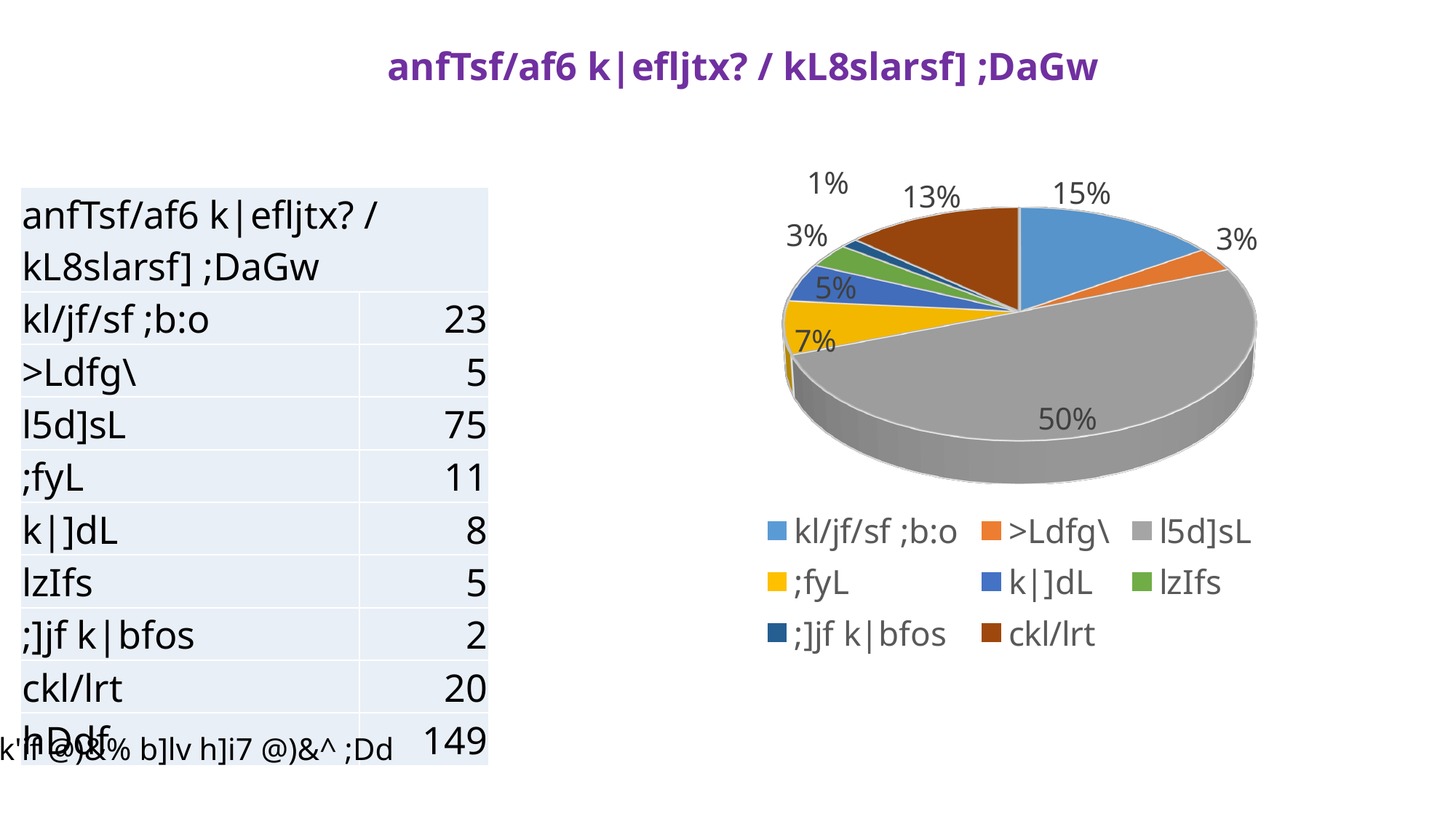
Which category has the smallest slice of the pie? ;]jf k|bfos What percentage is shown for the ckl/lrt slice? 13% What percentage is shown for the ;fyL slice? 7% What share of the pie does the l5d]sL slice represent? 50% How many entries does the legend list? 8 What is the difference in percentage points between the l5d]sL slice and the kl/jf/sf ;b:o slice? 35 How many slices does the pie chart have? 8 Which category has the largest slice of the pie? l5d]sL What percentage is shown for the k|]dL slice? 5% Which slice is larger, kl/jf/sf ;b:o or ckl/lrt? kl/jf/sf ;b:o What percentage is shown for the kl/jf/sf ;b:o slice? 15% What kind of chart is shown on the slide? pie chart